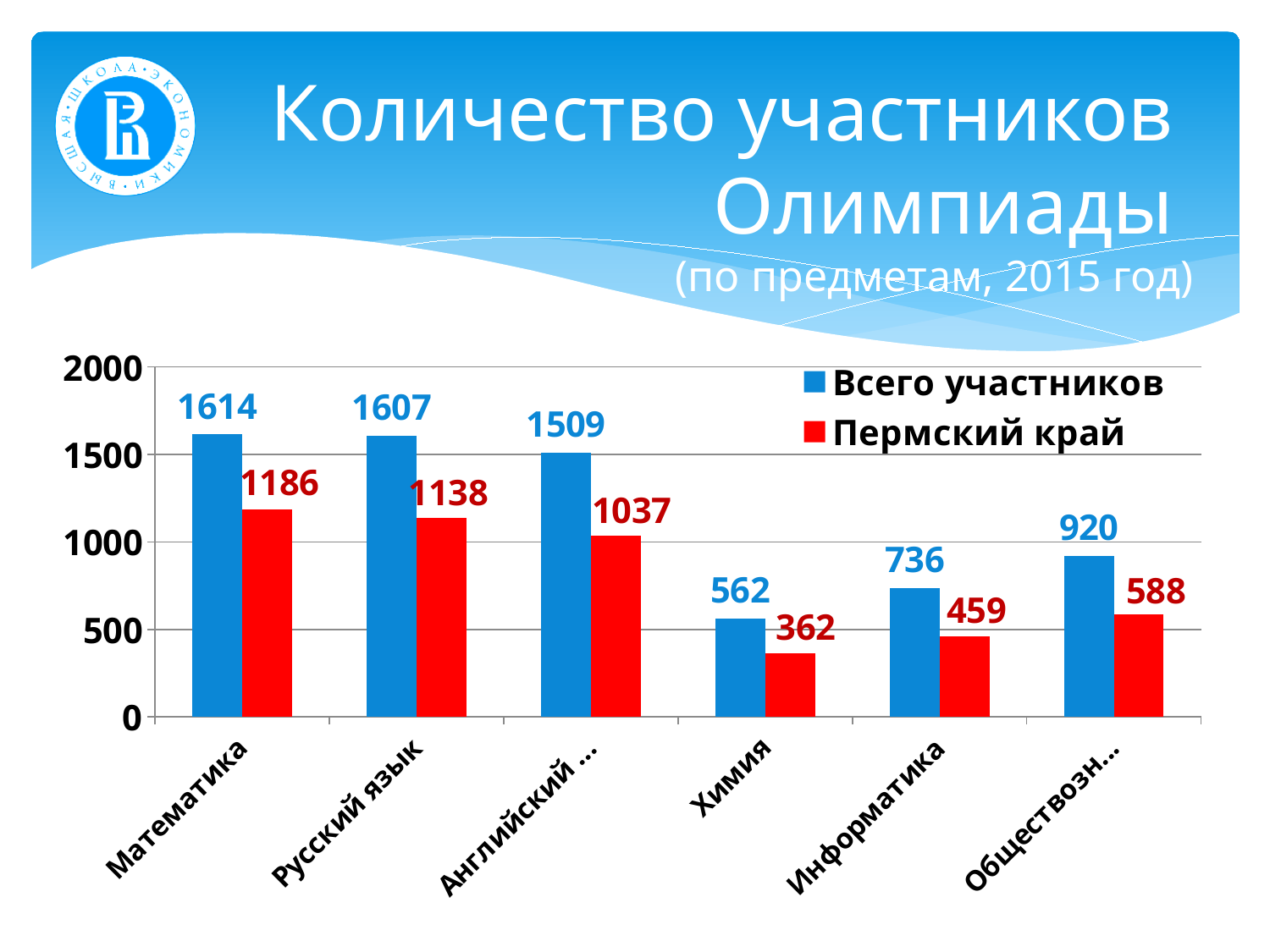
What is the difference between Всего участников and Пермский край for Информатика? 277 Which subject has the lowest value for Всего участников? Химия How many subject categories are shown on the x axis? 6 What kind of chart is shown on the slide? Bar chart What is the value of Всего участников for Математика? 1614 What is the value of Всего участников for Информатика? 736 What is the value of Пермский край for Русский язык? 1138 What is the difference between Всего участников and Пермский край for Математика? 428 For Пермский край, which is larger: Химия or Информатика? Информатика Which subject has the lowest value for Пермский край? Химия What is the value of Пермский край for Химия? 362 How many series does the legend list? 2